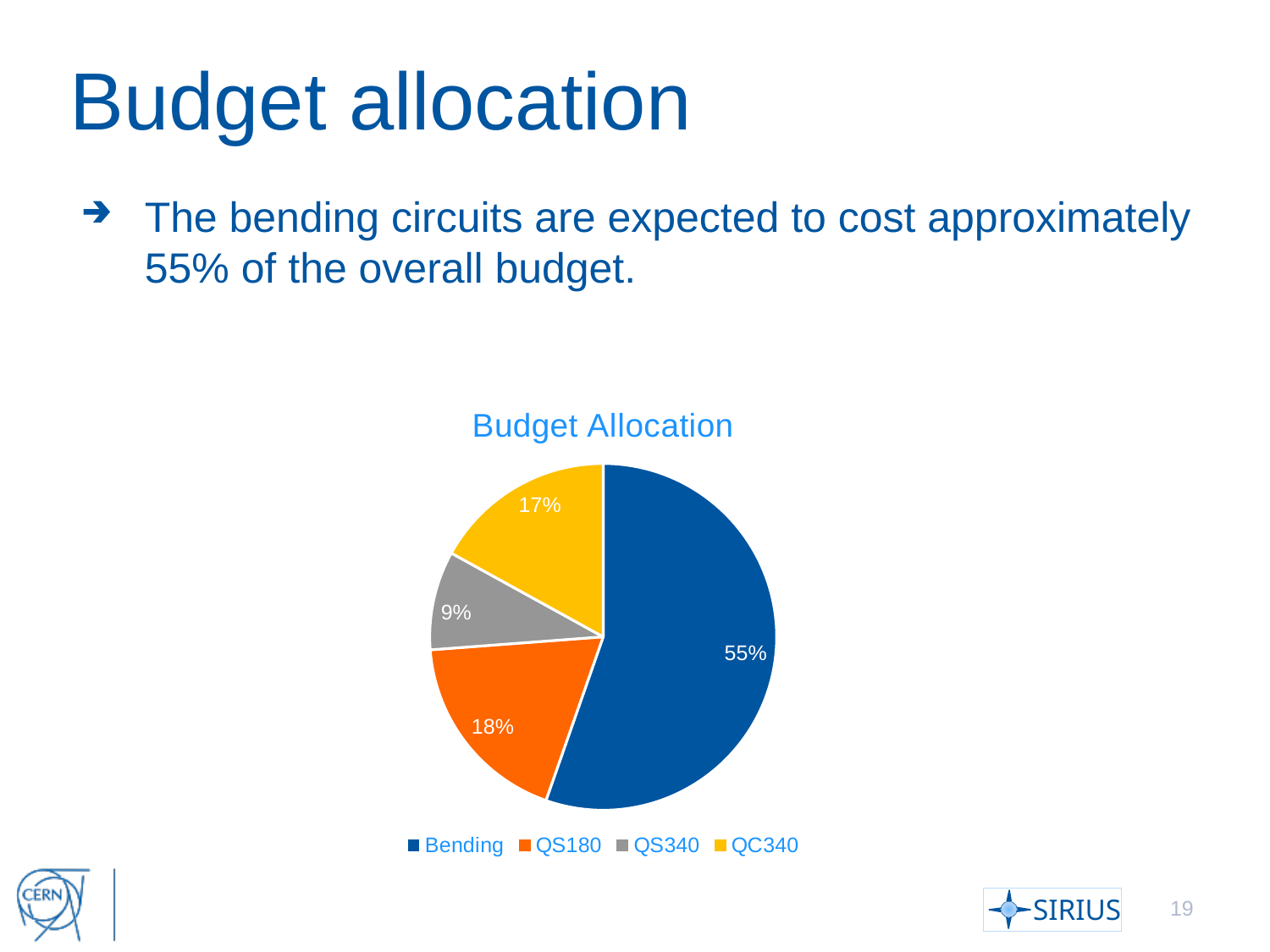
Which category has the largest share of the budget? Bending What share of the budget is allocated to QC340? 17% What share of the budget is allocated to QS340? 9% How many categories does the pie chart show? 4 What is the title of the chart? Budget Allocation What type of chart is shown on the slide? pie chart Which colour represents QC340 in the pie chart? yellow Which has a larger share of the budget, QS180 or QS340? QS180 What share of the budget is allocated to Bending? 55% What share of the budget is allocated to QS180? 18% Which category has the smallest share of the budget? QS340 What is the difference in percentage points between the Bending share and the QS180 share? 37